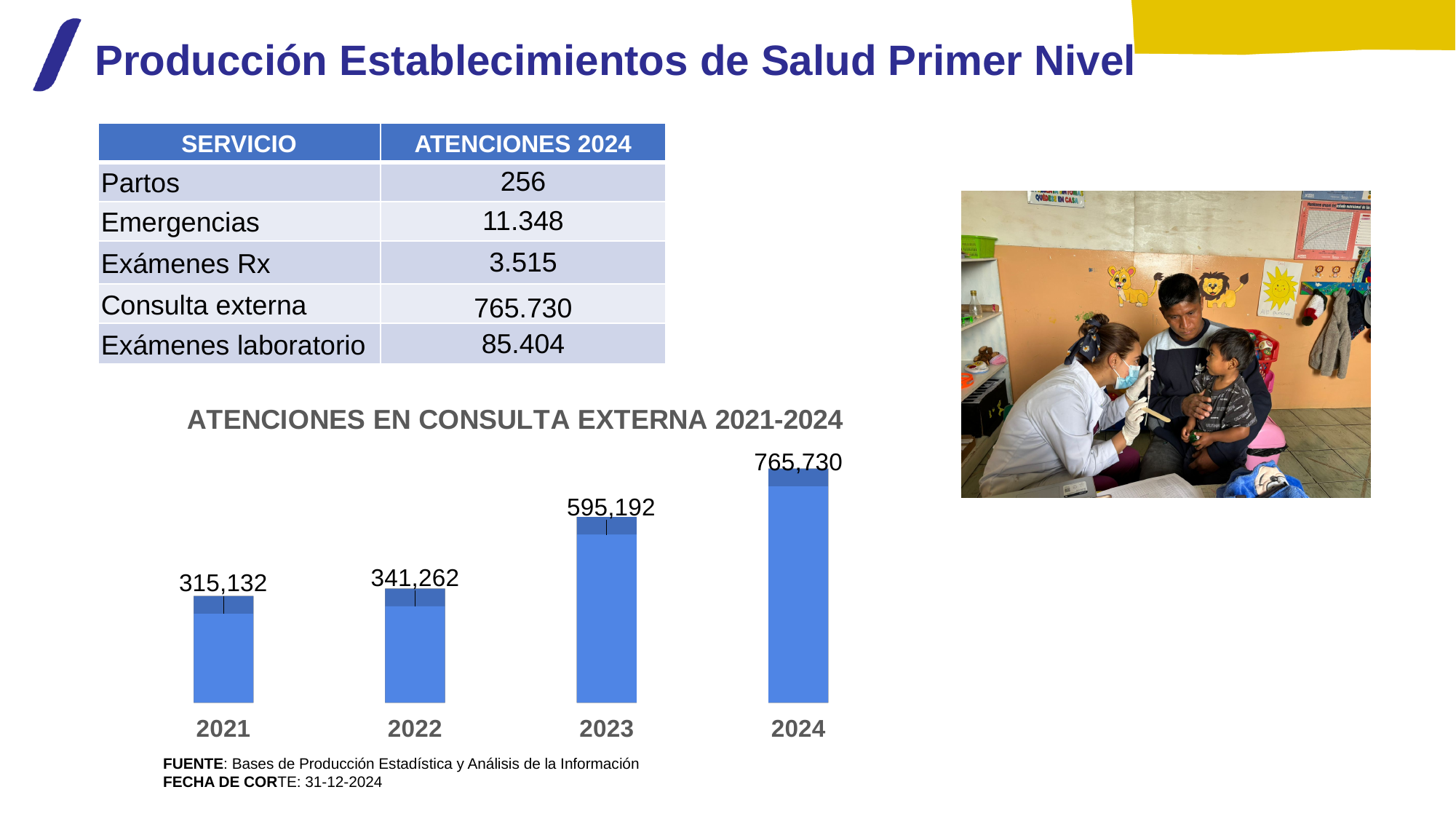
How many years (bars) are shown in the chart? 4 Which year has the highest value in the chart? 2024 Which is larger in the chart, the value for 2023 or the value for 2022? 2023 What is the value shown for 2023 in the chart? 595,192 What type of chart is shown under the title 'ATENCIONES EN CONSULTA EXTERNA 2021-2024'? bar chart Which year has the lowest value in the chart? 2021 What is the value shown for 2024 in the chart? 765,730 What is the value shown for 2022 in the chart? 341,262 What is the difference between the values for 2022 and 2021 in the chart? 26,130 Do the values in the chart rise or fall from 2021 to 2024? rise What is the value shown for 2021 in the chart? 315,132 What is the difference between the values for 2024 and 2023 in the chart? 170,538